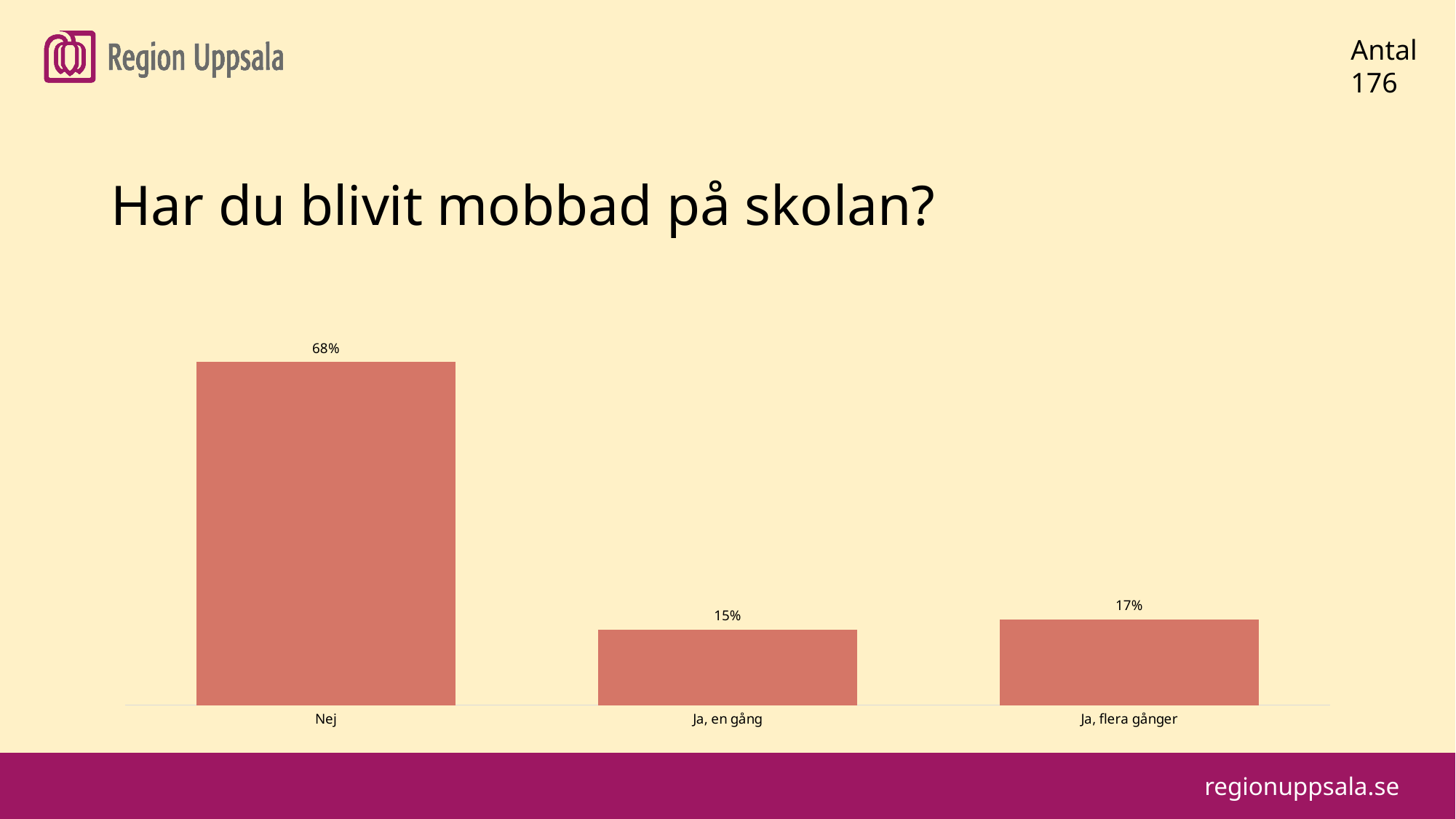
Which category has the highest value? Nej What is the difference between the values for "Ja, flera gånger" and "Ja, en gång"? 2 percentage points What is the value for "Ja, en gång"? 15% Which is larger, the value for "Ja, en gång" or the value for "Ja, flera gånger"? Ja, flera gånger Which category has the lowest value? Ja, en gång What is the title of the chart? Har du blivit mobbad på skolan? What kind of chart is shown on the slide? Bar chart How many categories are shown in the chart? 3 What is the number of respondents (Antal) shown on the slide? 176 What is the value for "Nej"? 68% What is the difference between the values for "Nej" and "Ja, flera gånger"? 51 percentage points What is the value for "Ja, flera gånger"? 17%